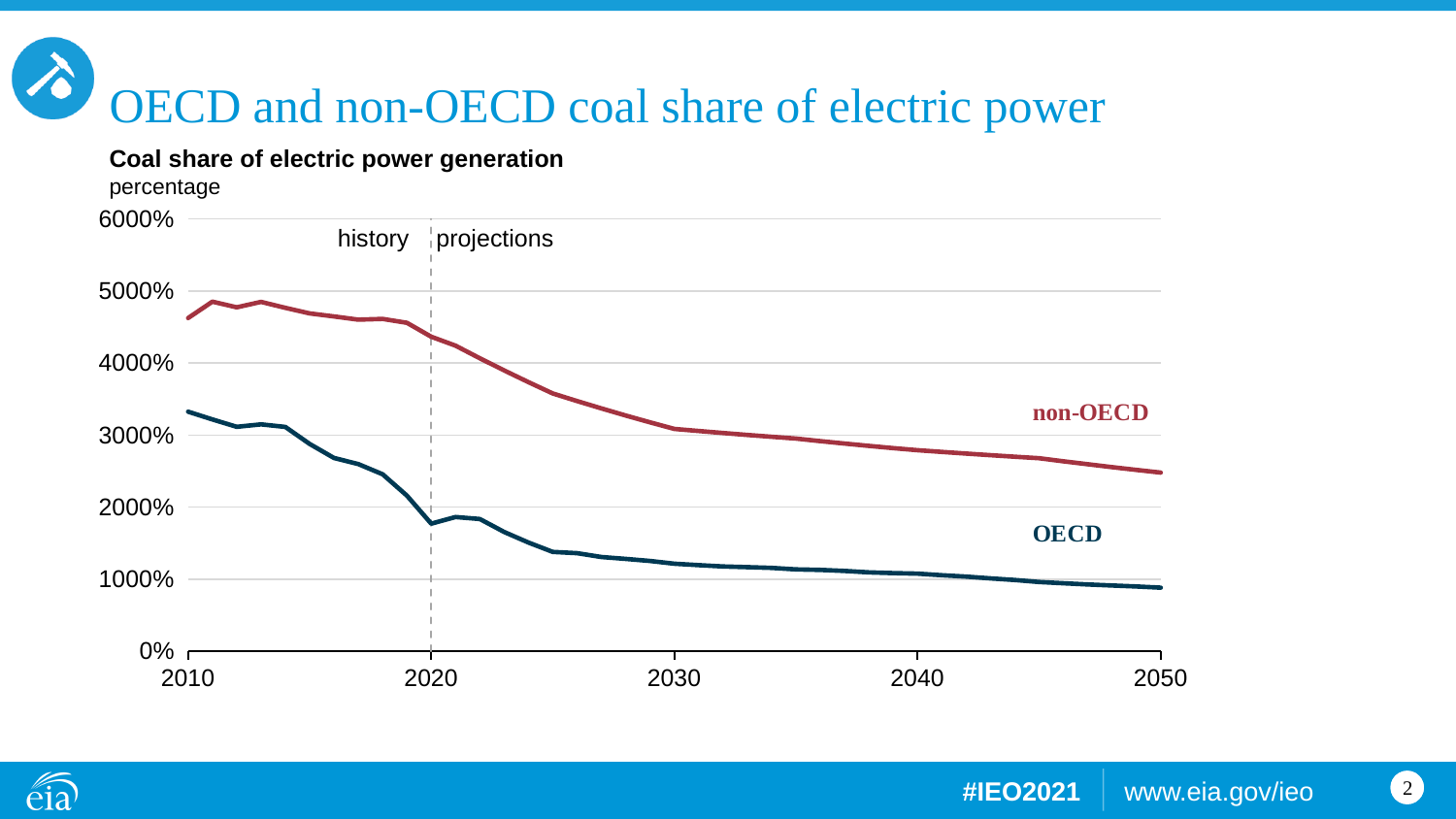
Does the non-OECD line rise or fall from 2020 to 2050? fall Is the value for OECD in 2020 greater or less than 2000%? less Is the value for OECD in 2010 greater or less than 3000%? greater How many series are plotted on the chart? 2 What kind of chart is shown on the slide? line chart Does the OECD line rise or fall from 2010 to 2050? fall Which series has the higher value in 2030, non-OECD or OECD? non-OECD What are the names of the two series plotted on the chart? non-OECD and OECD Is the value for non-OECD in 2050 greater or less than 3000%? less What is the title of the chart? Coal share of electric power generation